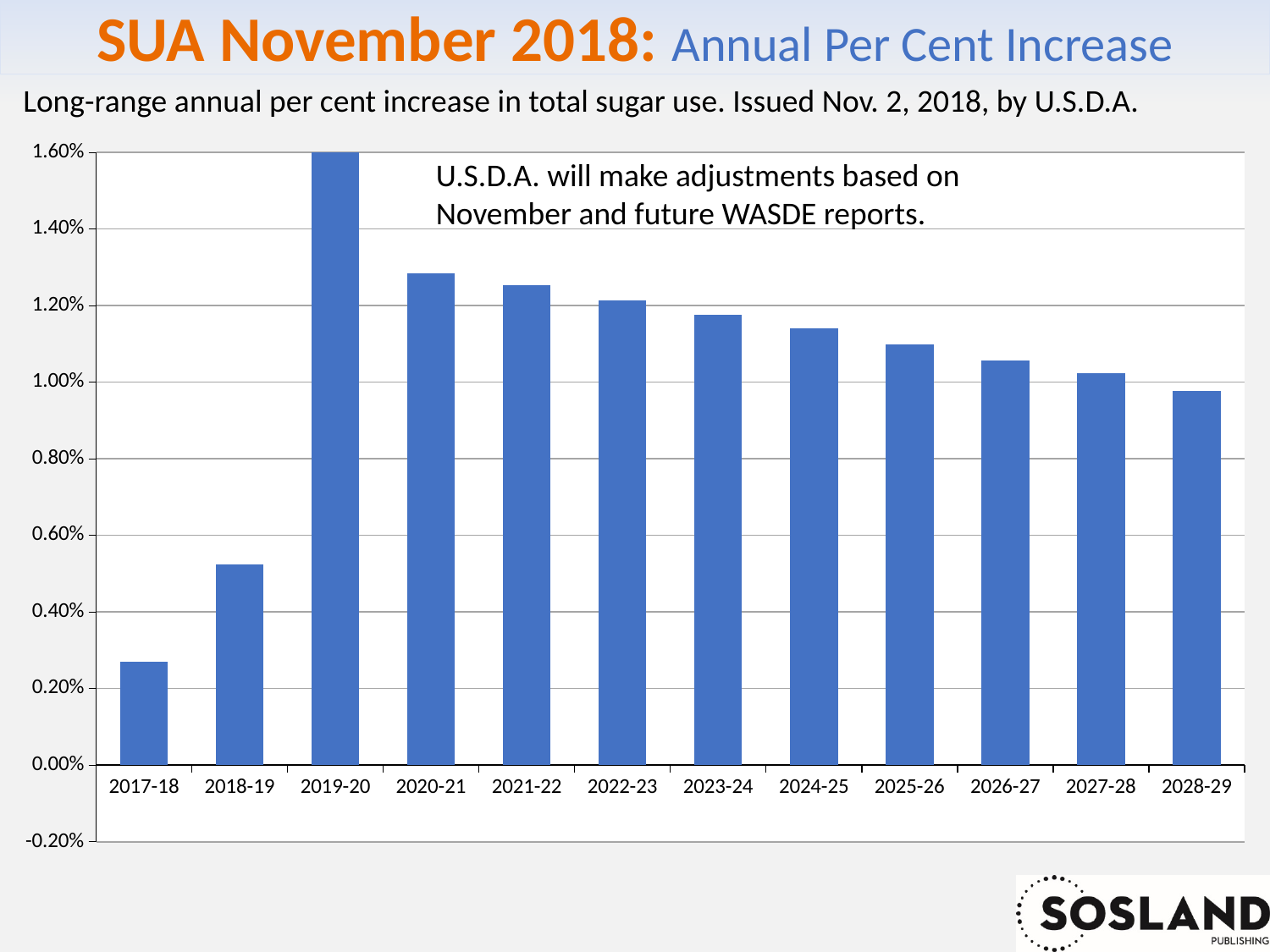
According to the text on the chart, what will U.S.D.A. base its adjustments on? November and future WASDE reports From 2019-20 to 2028-29, do the values rise or fall? fall Is the value for 2020-21 greater or less than 1.20%? greater Is the value for 2023-24 greater or less than 1.00%? greater Is the value for 2018-19 greater or less than 0.40%? greater Which crop year has the lowest annual per cent increase? 2017-18 What kind of chart is shown on the slide? bar chart How many crop years are plotted on the chart? 12 Which is larger, the value for 2018-19 or the value for 2020-21? 2020-21 Which crop year has the highest annual per cent increase? 2019-20